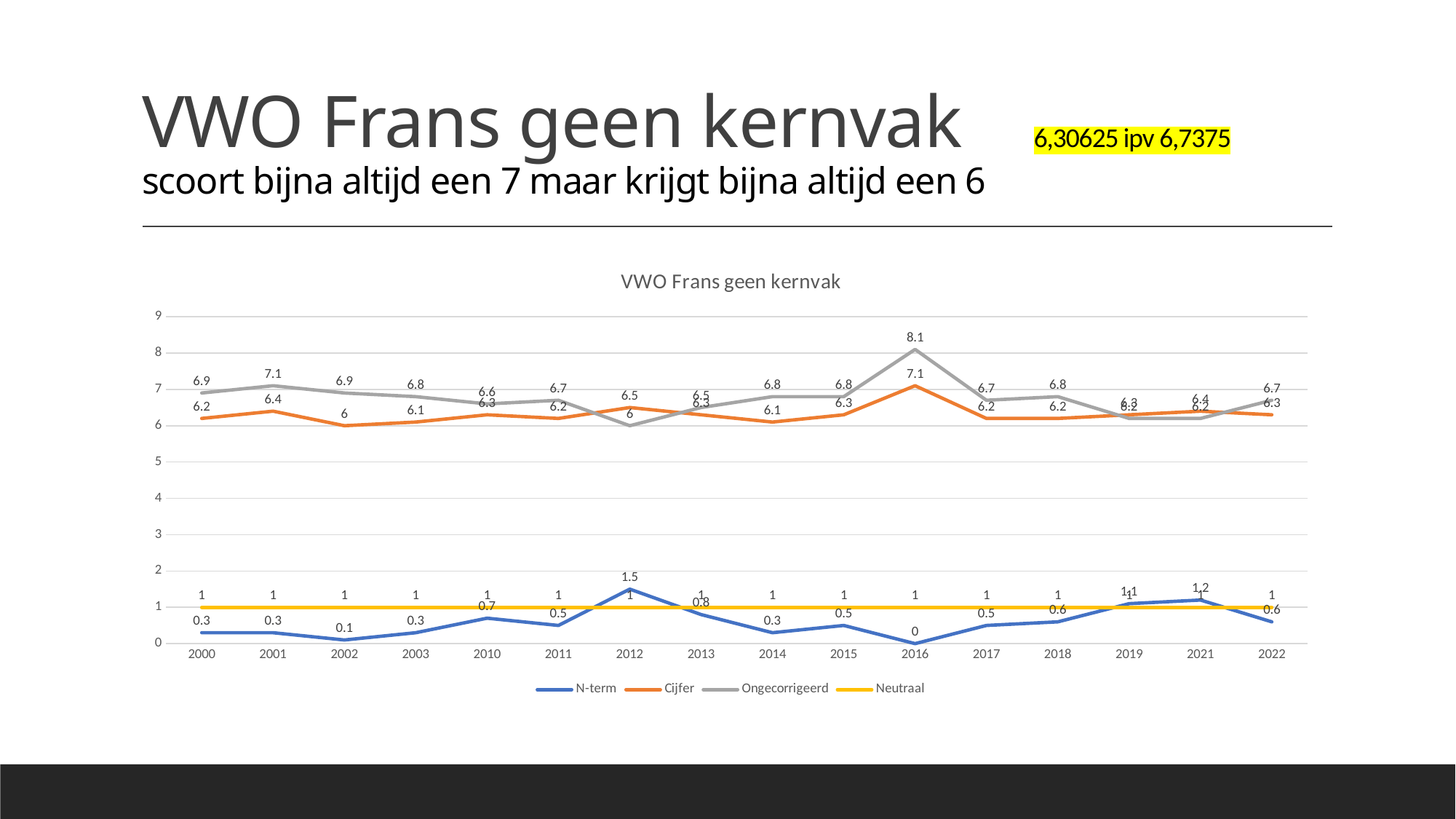
What kind of chart is shown on the slide? line chart How many series does the legend of the chart list? 4 What is the Ongecorrigeerd value for 2016? 8.1 In which year is the Ongecorrigeerd series at its highest? 2016 In which year is the N-term series at its lowest? 2016 In which year is the N-term series at its highest? 2012 What is the difference between the Ongecorrigeerd and Cijfer values in 2016? 1 What is the Cijfer value for 2016? 7.1 How many years are plotted along the x axis of the chart? 16 In which year is the Cijfer series at its lowest? 2002 In 2012, which is larger: the Cijfer value or the Ongecorrigeerd value? Cijfer What constant value does the Neutraal series have across all years? 1